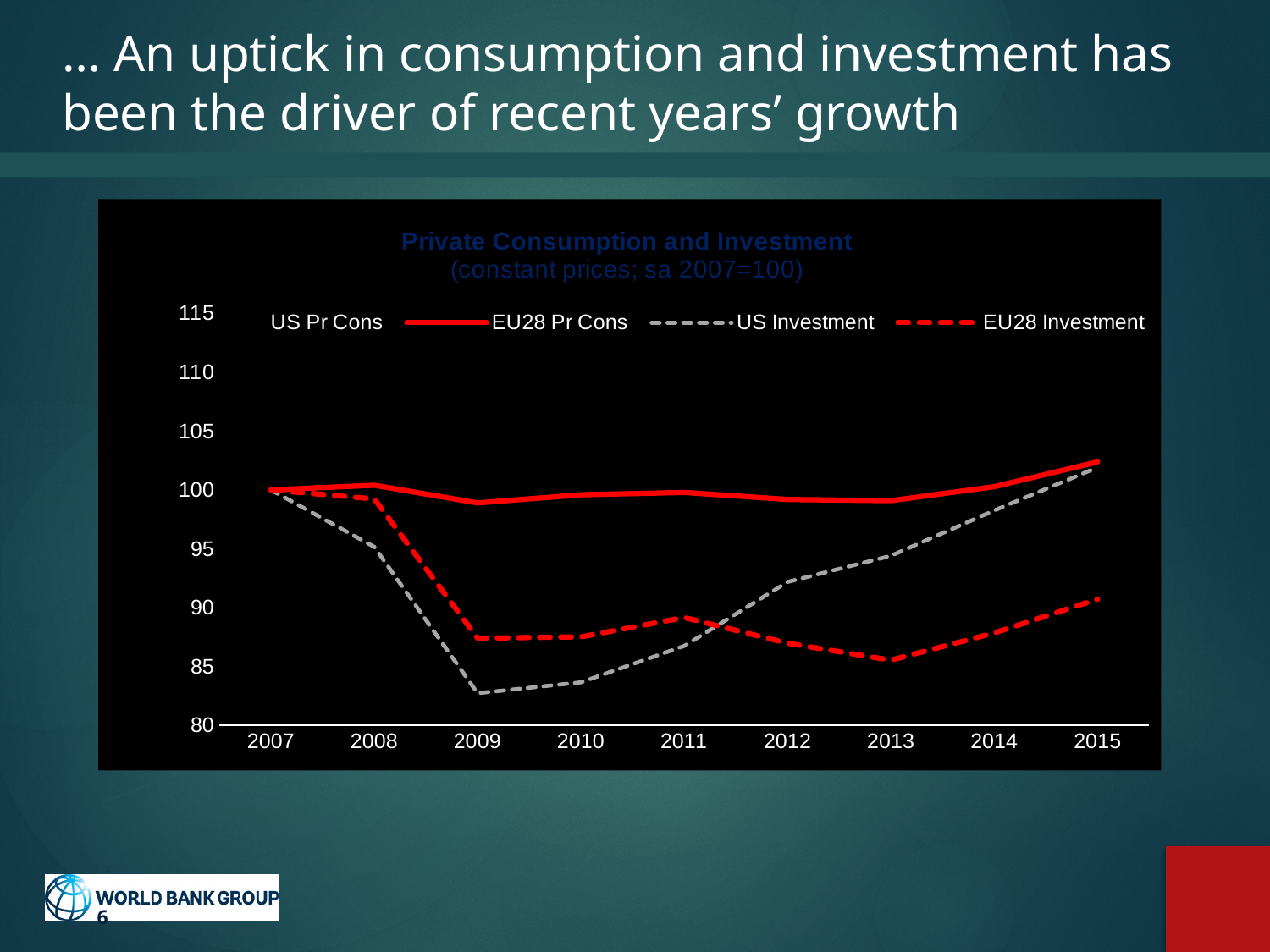
In 2009, which is higher: EU28 Investment or US Investment? EU28 Investment What is the title of the chart? Private Consumption and Investment Is the value for US Investment in 2015 greater or less than 100? greater How many series does the chart legend list? 4 In which year does the EU28 Investment line reach its lowest point? 2013 In 2015, which is higher: US Investment or EU28 Investment? US Investment Is the value for EU28 Investment in 2009 greater or less than 90? less In which year does the US Investment line reach its lowest point? 2009 What kind of chart is shown on the slide? line chart How many years are shown on the x axis of the chart? 9 Is the value for US Investment in 2009 greater or less than 85? less Does the US Investment line rise or fall between 2009 and 2015? rise